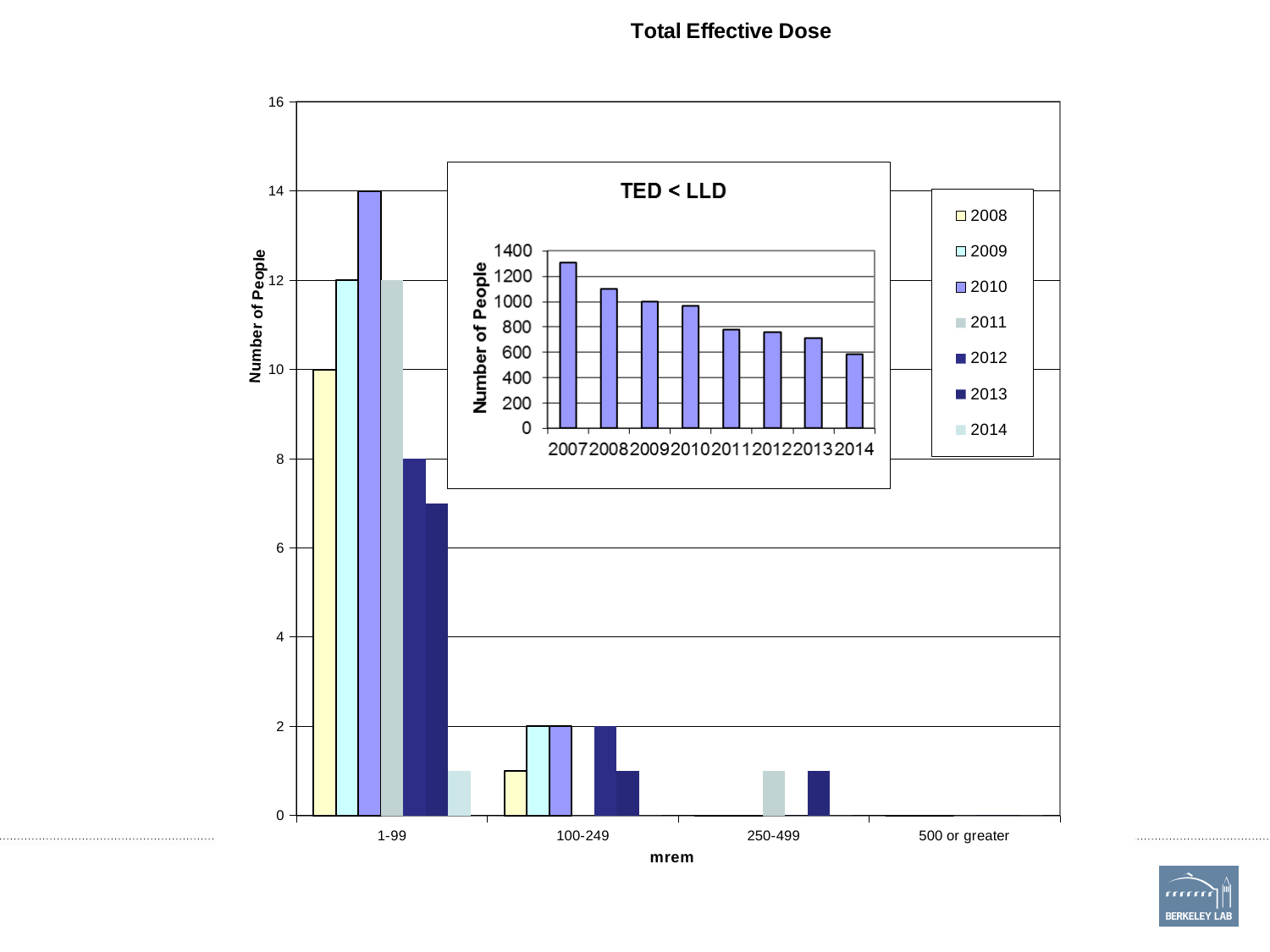
In the inset "TED < LLD" chart, is the value for 2007 greater or less than 1200? greater In the main "Total Effective Dose" chart, which is larger in the 1-99 mrem category: the value for 2009 or the value for 2012? 2009 In the main "Total Effective Dose" chart, which year has the highest number of people in the 1-99 mrem category? 2010 In the main "Total Effective Dose" chart, what is the difference between the 2010 and 2012 values in the 1-99 mrem category? 6 In the inset "TED < LLD" chart, do the values rise or fall from 2007 to 2014? fall In the main "Total Effective Dose" chart, what is the number of people for 2010 in the 1-99 mrem category? 14 In the inset "TED < LLD" chart, how many years are shown on the x axis? 8 In the main "Total Effective Dose" chart, how many series does the legend list? 7 In the main "Total Effective Dose" chart, what is the number of people for 2012 in the 1-99 mrem category? 8 What kind of chart is the inset "TED < LLD" chart? bar chart What kind of chart is the main "Total Effective Dose" chart? bar chart In the main "Total Effective Dose" chart, how many mrem categories are shown on the x axis? 4